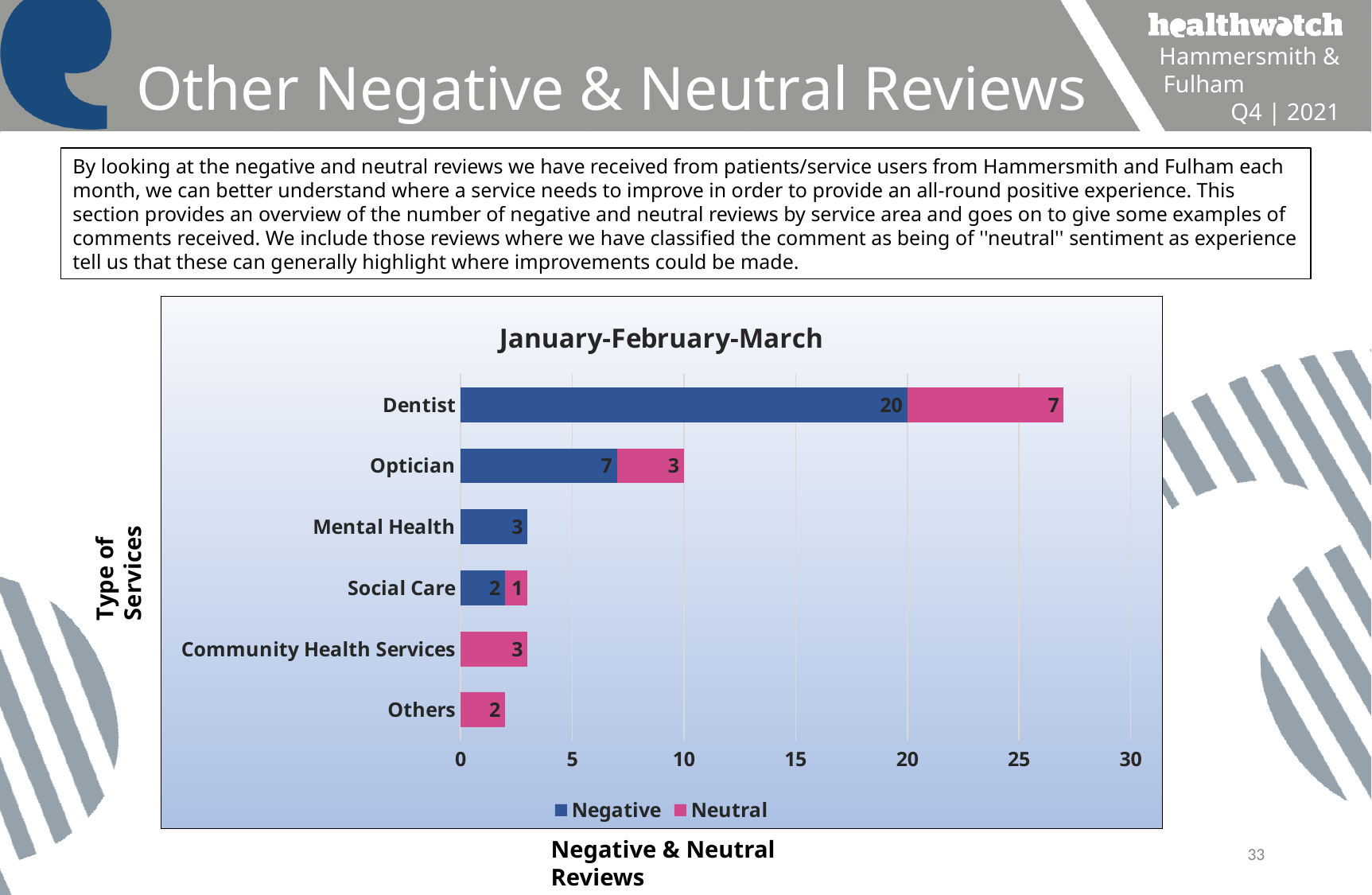
What is the total of the stacked bar for Social Care? 3 What is the Neutral value for Optician? 3 Which is larger, the Neutral value for Dentist or the Neutral value for Optician? Dentist Which category has the lowest Neutral value among those with a Neutral label? Social Care What is the Negative value for Dentist? 20 What is the difference between the Negative values for Dentist and Optician? 13 What is the total of the stacked bar for Dentist? 27 What is the Neutral value for Community Health Services? 3 How many categories are shown on the chart? 6 How many series does the legend list? 2 What kind of chart is shown? Bar chart Which category has the highest Negative value? Dentist